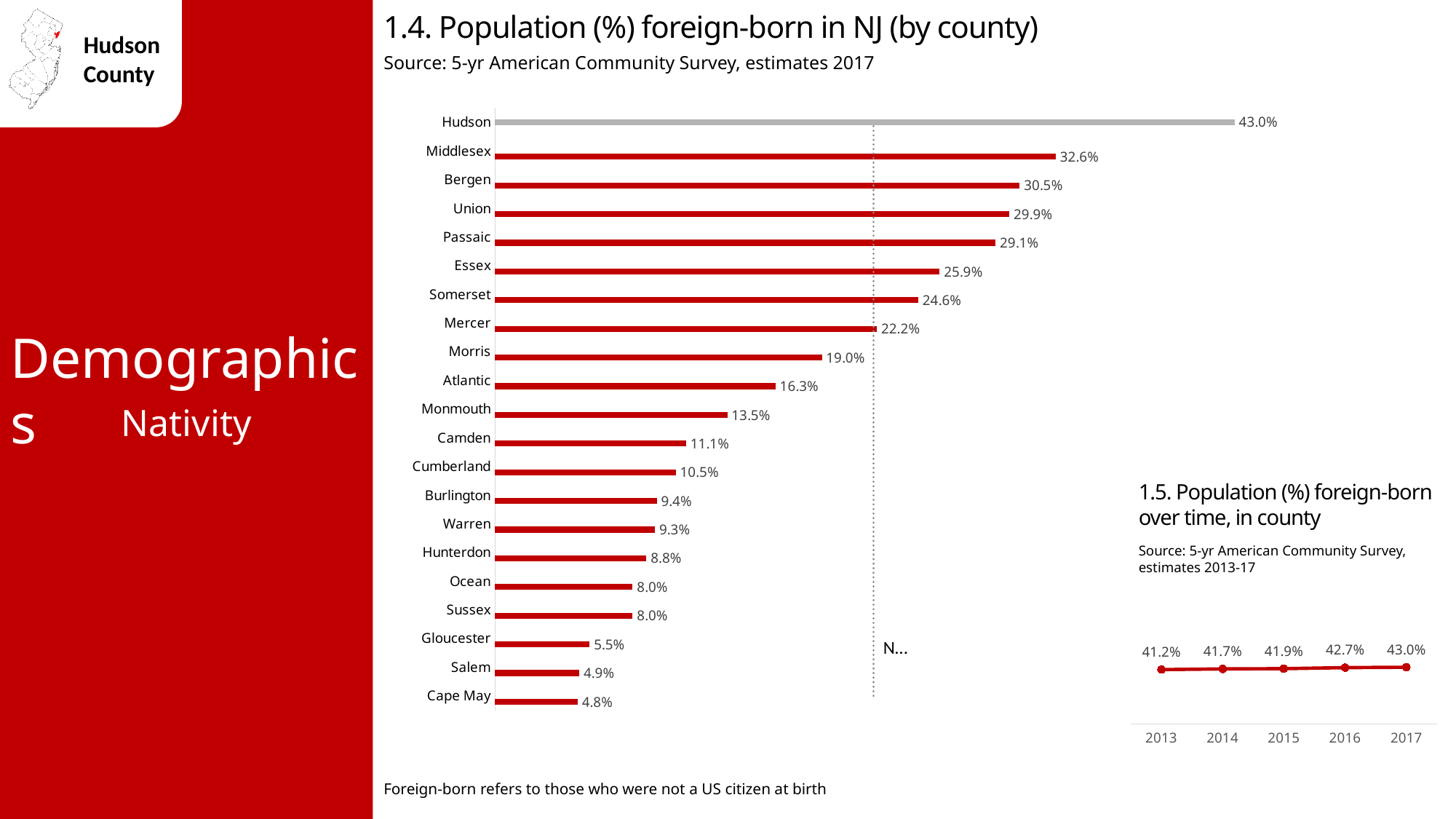
In chart 1.5 (Population (%) foreign-born over time, in county), what is the difference between 2017 and 2013? 1.8% In chart 1.4 (Population (%) foreign-born in NJ by county), what is the value for Mercer? 22.2% In chart 1.5 (Population (%) foreign-born over time, in county), what is the value for 2015? 41.9% In chart 1.4 (Population (%) foreign-born in NJ by county), which is larger, Morris or Atlantic? Morris In chart 1.4 (Population (%) foreign-born in NJ by county), which county has the highest value? Hudson What kind of chart is chart 1.4 (Population (%) foreign-born in NJ by county)? Bar chart In chart 1.4 (Population (%) foreign-born in NJ by county), which county has the lowest value? Cape May In chart 1.4 (Population (%) foreign-born in NJ by county), what is the value for Hudson? 43.0% In chart 1.5 (Population (%) foreign-born over time, in county), do the values rise or fall from 2013 to 2017? Rise In chart 1.4 (Population (%) foreign-born in NJ by county), what is the difference between Middlesex and Bergen? 2.1% In chart 1.4 (Population (%) foreign-born in NJ by county), how many counties are shown? 21 What kind of chart is chart 1.5 (Population (%) foreign-born over time, in county)? Line chart